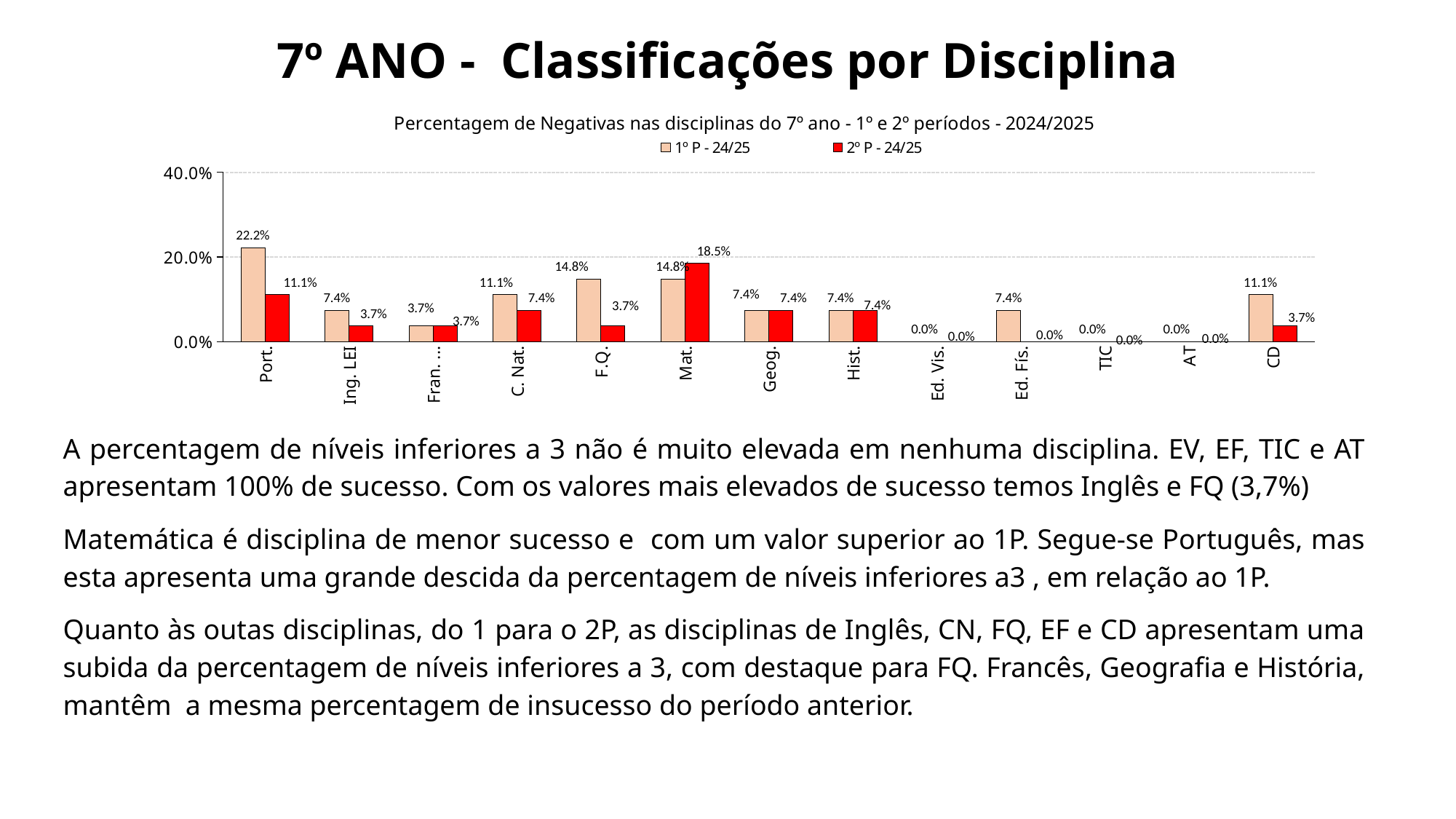
Which discipline has the highest value in the 1º P - 24/25 series? Port. What is the title of the chart? Percentagem de Negativas nas disciplinas do 7º ano - 1º e 2º períodos - 2024/2025 What is the difference between the 1º P - 24/25 and 2º P - 24/25 values for Port.? 11.1% What kind of chart is shown on the slide? Bar chart Which discipline has the highest value in the 2º P - 24/25 series? Mat. What is the value for F.Q. in the 2º P - 24/25 series? 3.7% How many series does the legend list? 2 Is the value for Port. in the 1º P - 24/25 series greater or less than 20.0%? greater What is the value for Port. in the 1º P - 24/25 series? 22.2% Which is larger for Mat.: the 1º P - 24/25 value or the 2º P - 24/25 value? 2º P - 24/25 How many disciplines are shown on the x axis? 13 What is the value for Mat. in the 2º P - 24/25 series? 18.5%